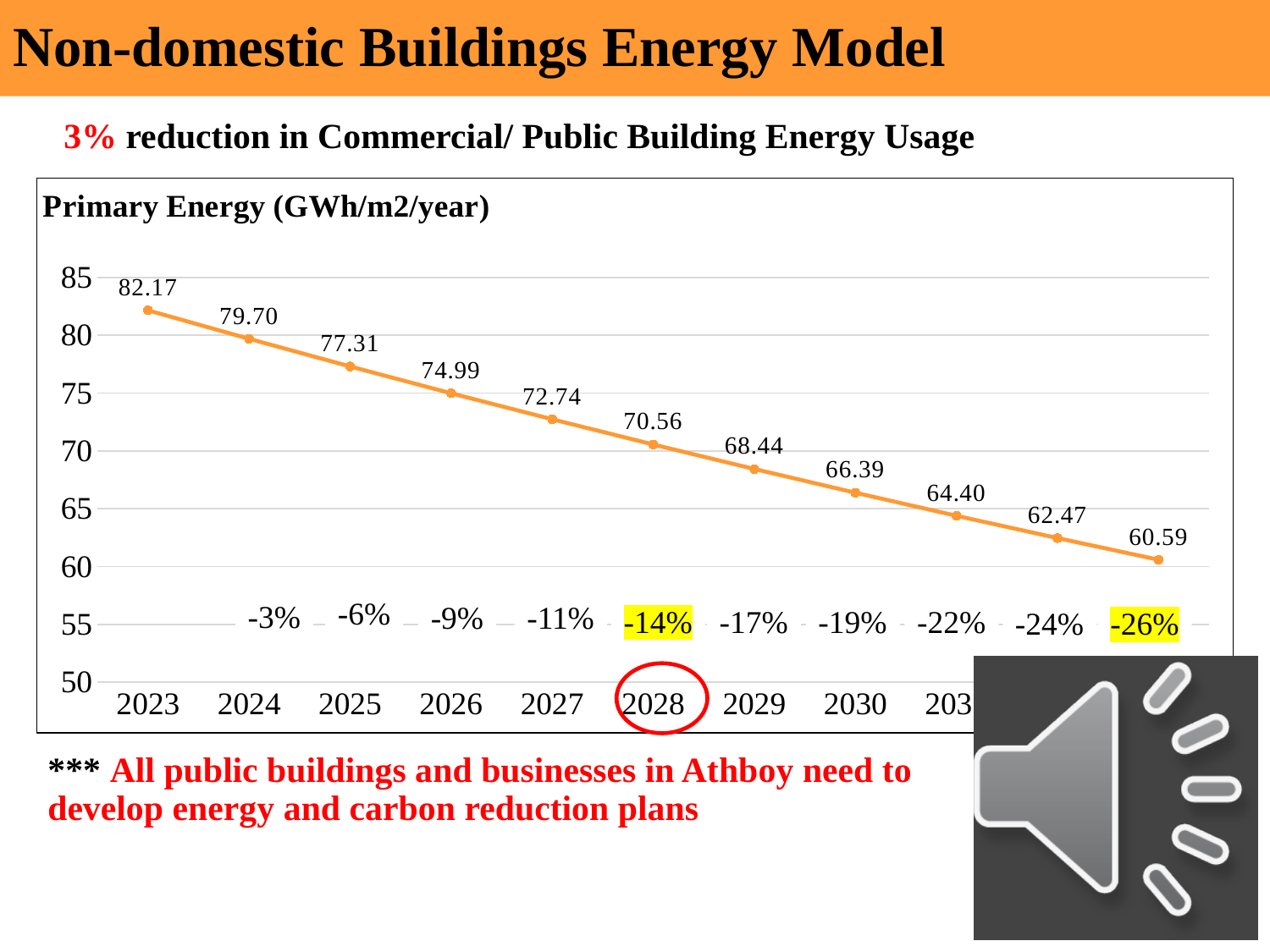
Do the Primary Energy values rise or fall from 2023 onwards? fall What is the Primary Energy value for 2023? 82.17 What percentage reduction label is shown for 2028? -14% What is the Primary Energy value for 2028? 70.56 Which year has the highest Primary Energy value? 2023 What kind of chart is shown on the slide? line chart What is the difference between the Primary Energy values for 2023 and 2024? 2.47 What is the Primary Energy value for 2030? 66.39 Is the Primary Energy value for 2029 greater or less than 70? less What is the title of the chart? Primary Energy (GWh/m2/year) How many data points are plotted on the line? 11 Which year has the larger Primary Energy value, 2025 or 2027? 2025